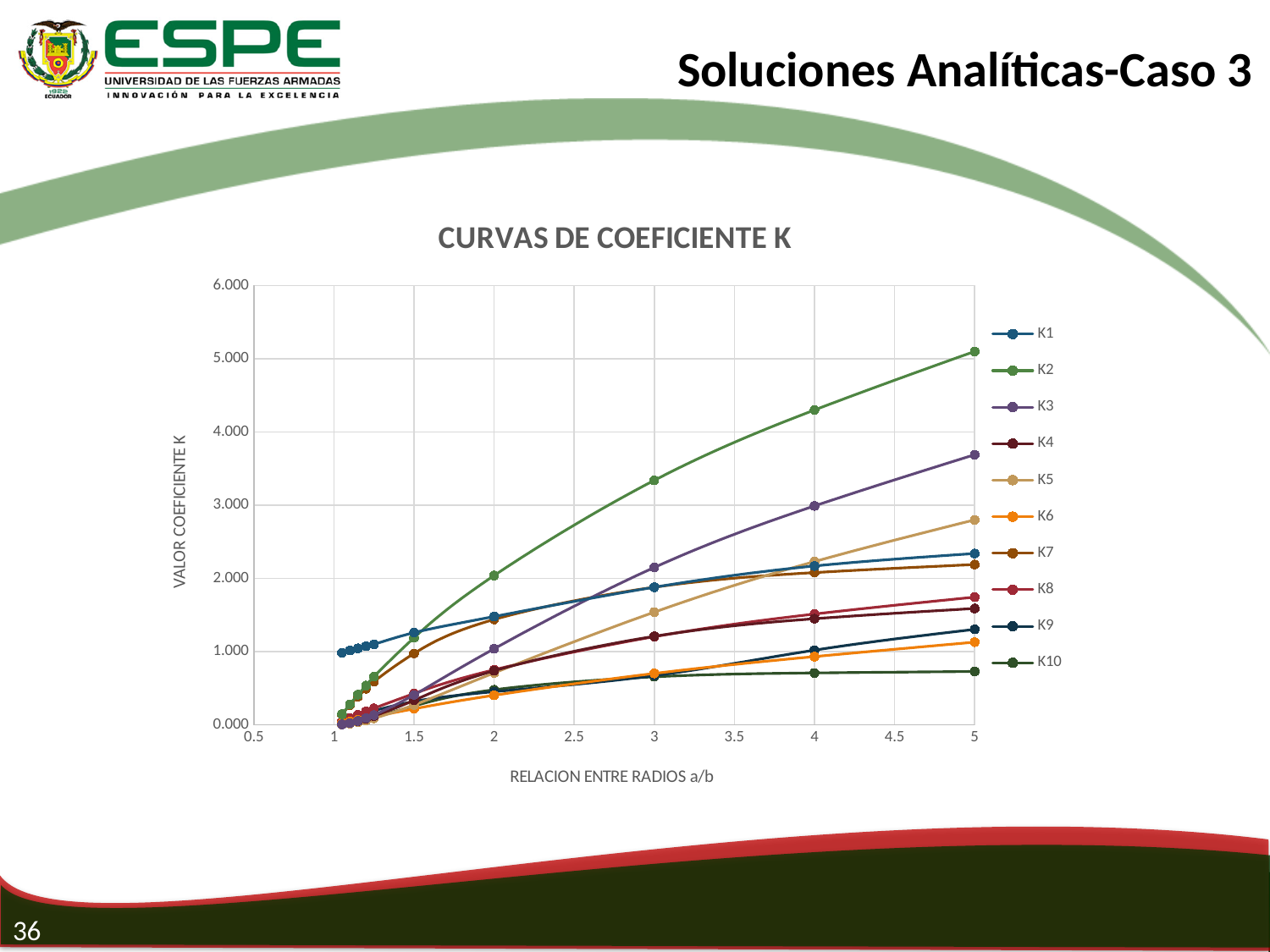
What is the label of the x axis? RELACION ENTRE RADIOS a/b Is the value of K3 at a/b = 5 greater or less than 3.000? greater Which series has the highest value at a/b = 5? K2 How many series does the legend list? 10 Does the K2 curve rise or fall as a/b increases? rise What is the title of the chart? CURVAS DE COEFICIENTE K Which series has the lowest value at a/b = 5? K10 Is the value of K2 at a/b = 4 greater or less than 4.000? greater At a/b = 5, which is larger, K5 or K8? K5 Is the value of K10 at a/b = 5 greater or less than 1.000? less What kind of chart is shown on the slide? line chart